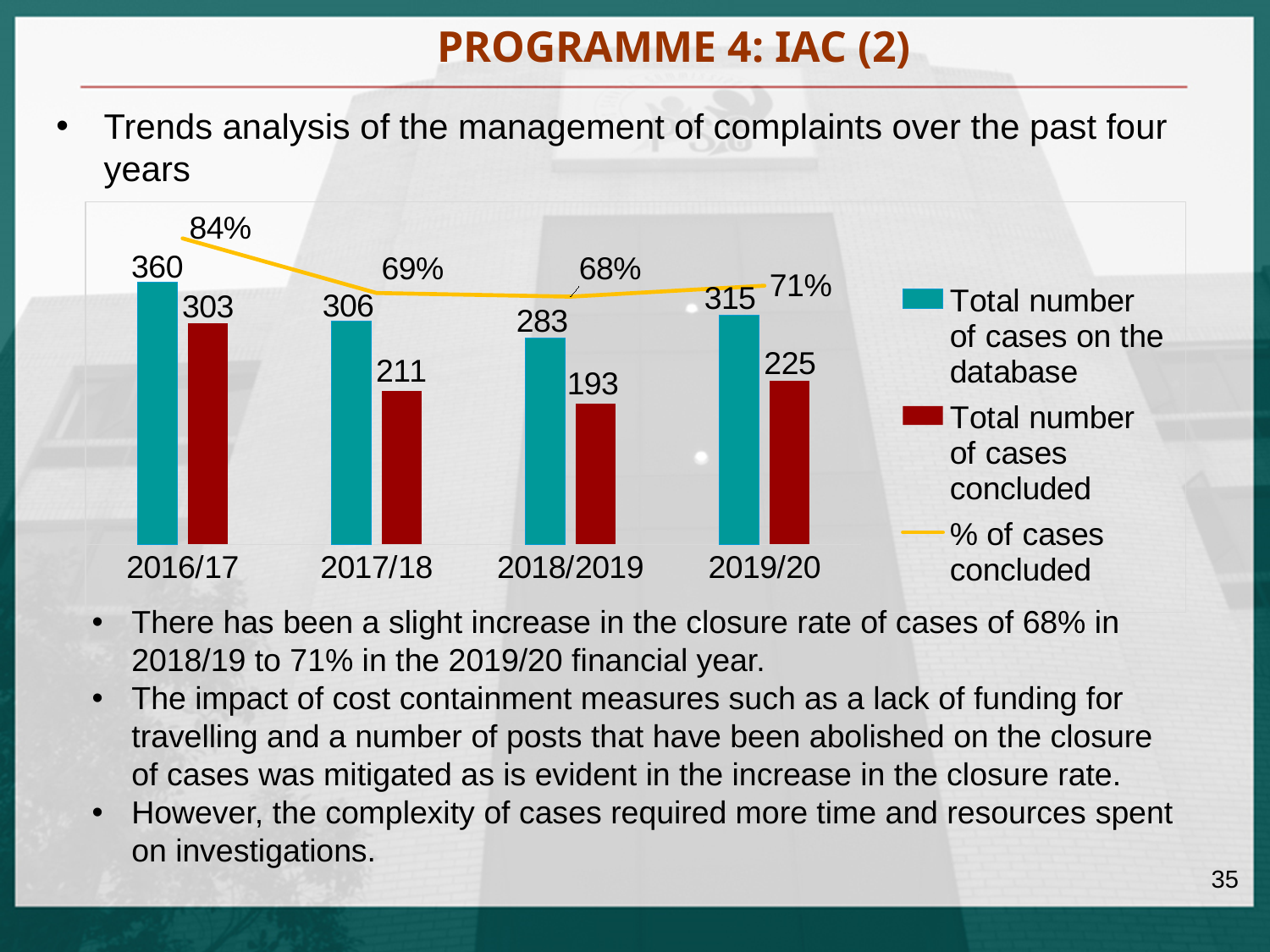
What is the % of cases concluded for 2019/20? 71% What is the total number of cases concluded in 2018/2019? 193 Which colour represents the total number of cases concluded in the chart? Dark red What is the difference between the total number of cases on the database and the total number of cases concluded in 2017/18? 95 What is the total number of cases on the database for 2016/17? 360 Does the % of cases concluded rise or fall from 2016/17 to 2017/18? Fall Which year has the lowest total number of cases concluded? 2018/2019 How many series does the chart legend list? 3 How many years are shown on the x axis of the chart? 4 Which is larger: the total number of cases concluded in 2016/17 or in 2019/20? 2016/17 Which year has the highest total number of cases on the database? 2016/17 What kind of chart is used to show the total number of cases on the database and cases concluded? Bar chart